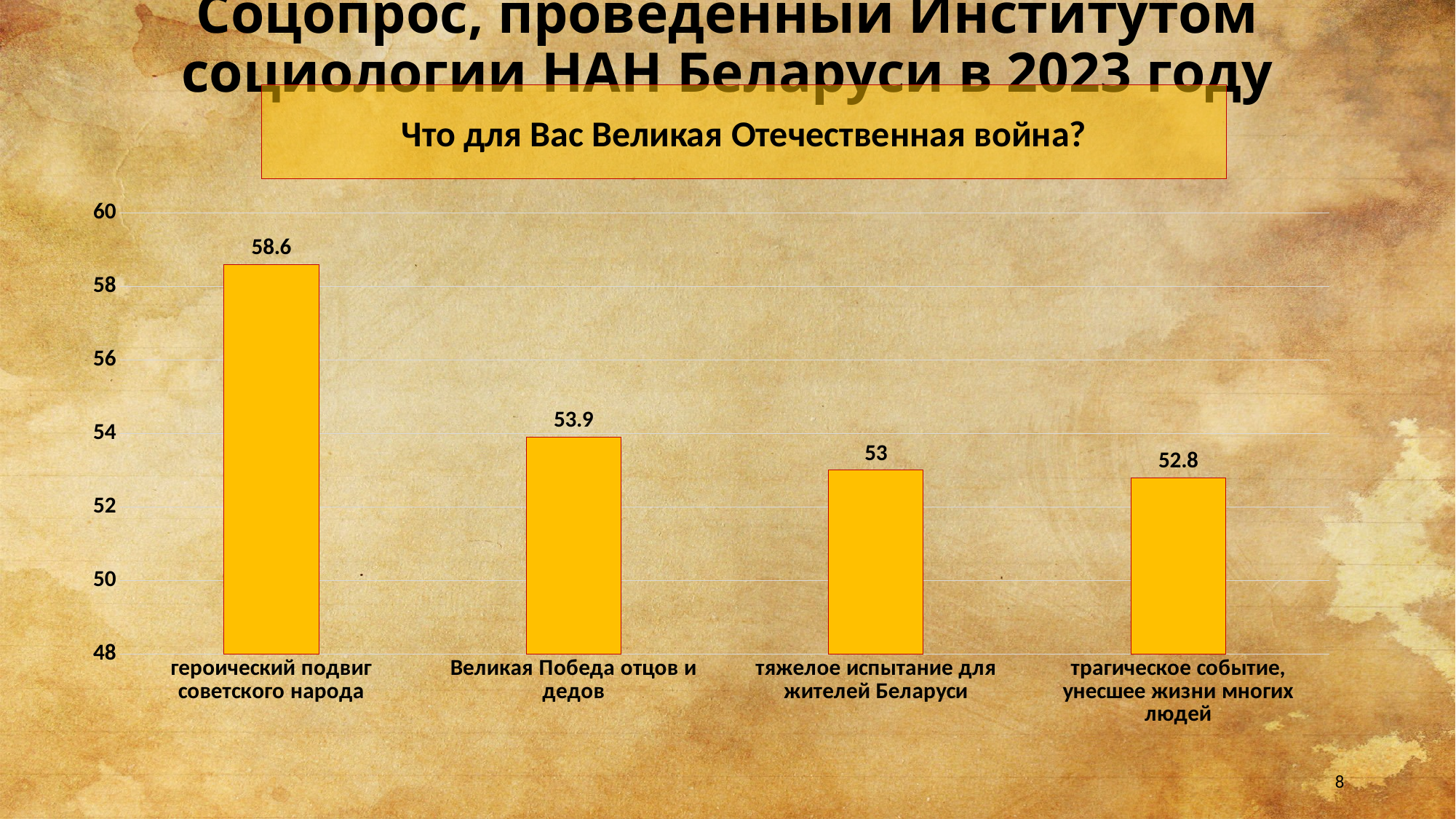
What is the difference between the values for "героический подвиг советского народа" and "Великая Победа отцов и дедов"? 4.7 What is the value for "героический подвиг советского народа"? 58.6 What is the value for "трагическое событие, унесшее жизни многих людей"? 52.8 What is the value for "тяжелое испытание для жителей Беларуси"? 53 Which category has the highest value? героический подвиг советского народа What is the title of the chart? Что для Вас Великая Отечественная война? What is the value for "Великая Победа отцов и дедов"? 53.9 Which category has the lowest value? трагическое событие, унесшее жизни многих людей What kind of chart is shown on the slide? bar chart Which is larger: the value for "Великая Победа отцов и дедов" or for "тяжелое испытание для жителей Беларуси"? Великая Победа отцов и дедов Is the value for "героический подвиг советского народа" greater or less than 56? greater How many categories are shown in the chart? 4